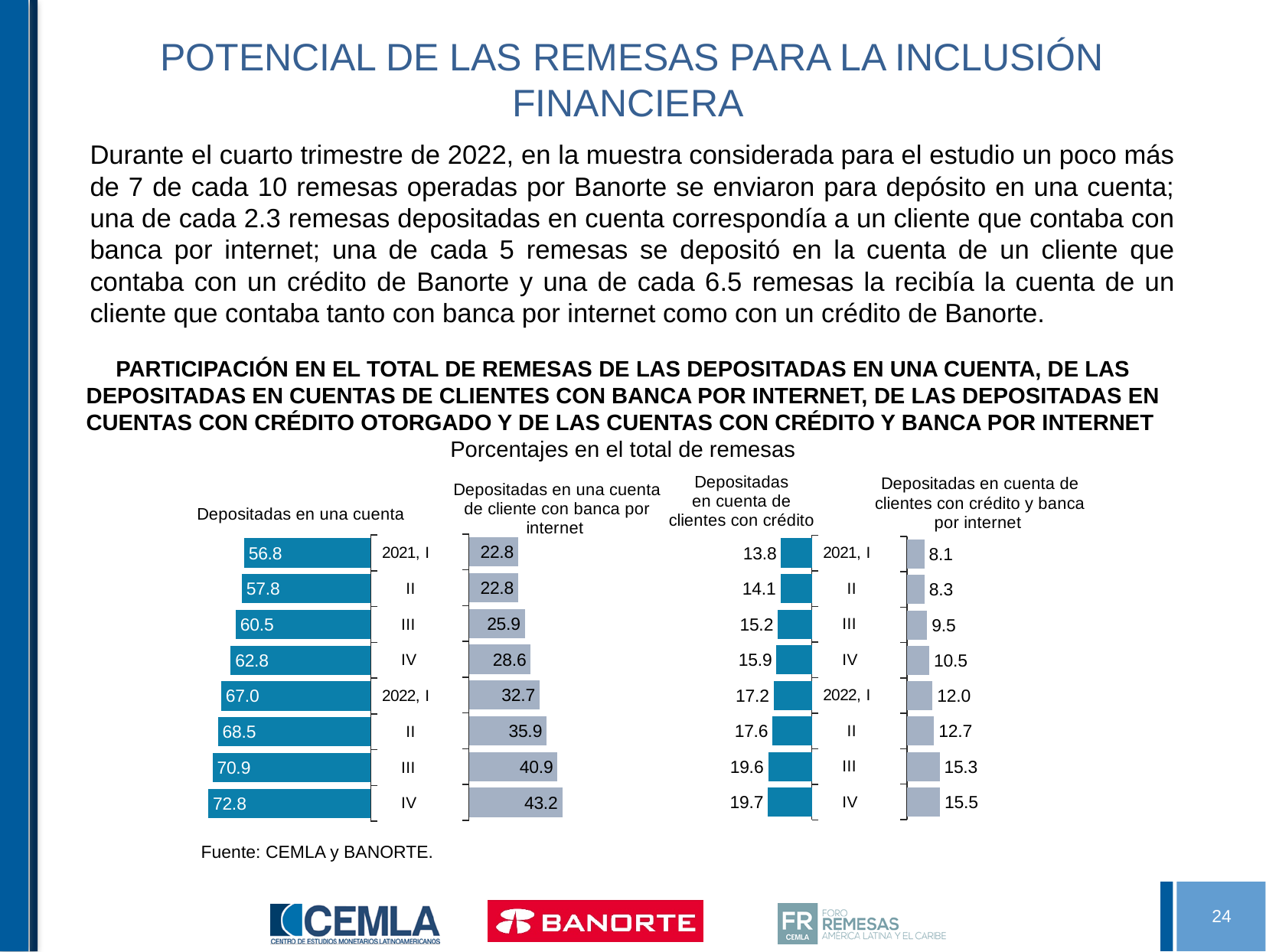
In the chart 'Depositadas en una cuenta', which quarter has the lowest value? 2021, I In the chart 'Depositadas en cuenta de clientes con crédito', what is the value for 2022, I? 17.2 In the chart 'Depositadas en cuenta de clientes con crédito y banca por internet', what is the value for 2021, III? 9.5 What kind of chart is 'Depositadas en una cuenta de cliente con banca por internet'? Bar chart How many quarters are plotted in the chart 'Depositadas en una cuenta'? 8 In the chart 'Depositadas en cuenta de clientes con crédito y banca por internet', what is the difference between the values for 2022, III and 2022, II? 2.6 In the chart 'Depositadas en una cuenta', what is the difference between the values for 2022, IV and 2021, I? 16.0 In the chart 'Depositadas en cuenta de clientes con crédito y banca por internet', do the values rise or fall from 2021, I to 2022, IV? Rise In the chart 'Depositadas en una cuenta de cliente con banca por internet', what is the value for 2021, IV? 28.6 In the chart 'Depositadas en cuenta de clientes con crédito', which is larger, the value for 2021, IV or the value for 2022, II? 2022, II In the chart 'Depositadas en una cuenta', what is the value for 2022, IV? 72.8 In the chart 'Depositadas en una cuenta de cliente con banca por internet', which quarter has the highest value? 2022, IV